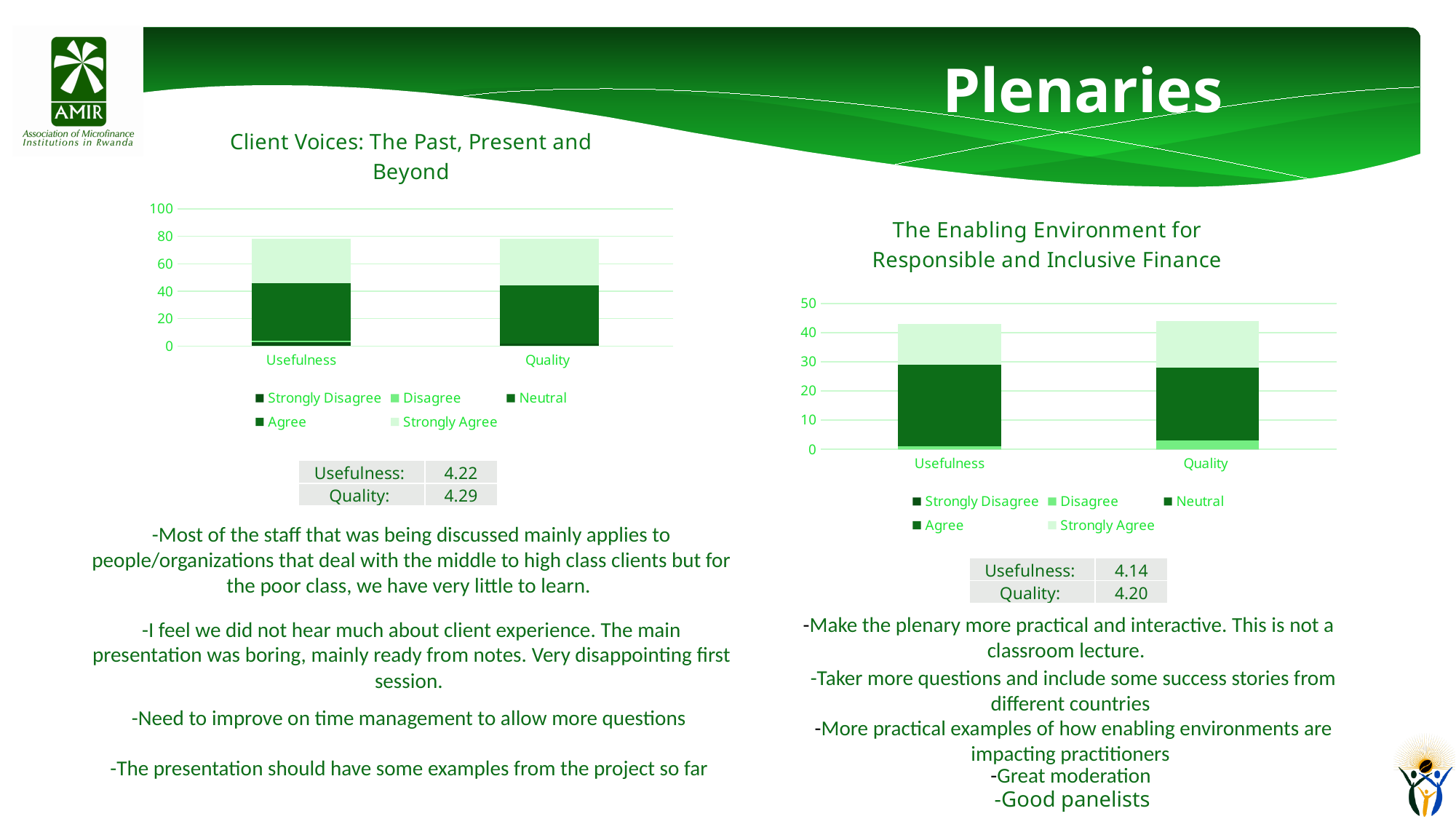
In the 'The Enabling Environment for Responsible and Inclusive Finance' chart, is the total height of the Usefulness bar greater or less than 30? greater In the 'Client Voices: The Past, Present and Beyond' chart, is the total height of the Quality bar greater or less than 100? less In the 'The Enabling Environment for Responsible and Inclusive Finance' chart, how many series does the legend list? 5 In the 'Client Voices: The Past, Present and Beyond' chart, is the total height of the Usefulness bar greater or less than 60? greater In the 'Client Voices: The Past, Present and Beyond' chart, how many categories are shown on the x axis? 2 What is the highest value shown on the y axis of the 'Client Voices: The Past, Present and Beyond' chart? 100 What are the two categories on the x axis of the 'The Enabling Environment for Responsible and Inclusive Finance' chart? Usefulness and Quality What kind of chart is shown under the title 'Client Voices: The Past, Present and Beyond'? Stacked bar chart What kind of chart is shown under the title 'The Enabling Environment for Responsible and Inclusive Finance'? Stacked bar chart In the 'Client Voices: The Past, Present and Beyond' chart, how many series does the legend list? 5